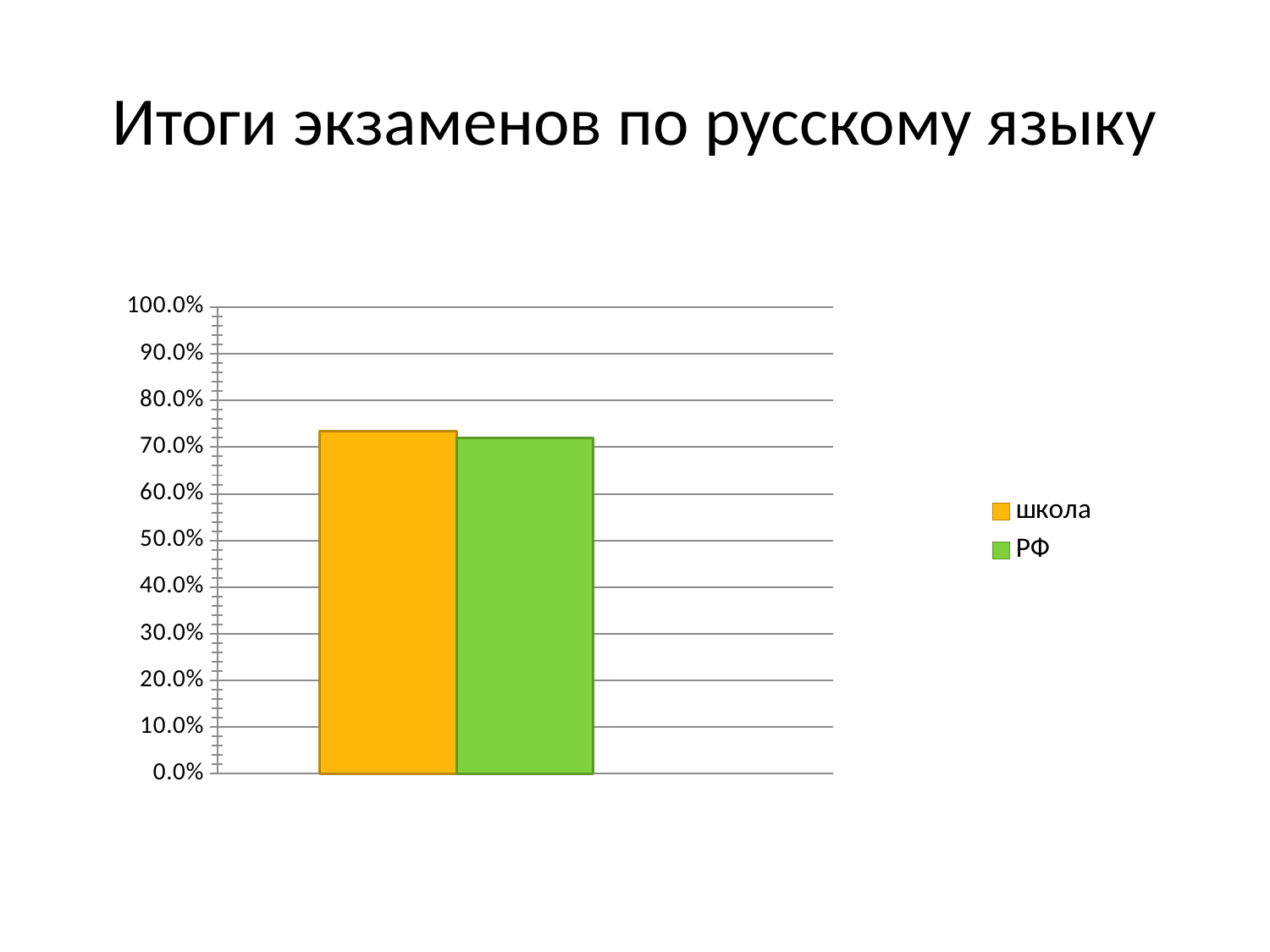
What is the title of the slide containing the chart? Итоги экзаменов по русскому языку How many series does the legend list? 2 How many bars are plotted on the chart? 2 Is the value for РФ greater or less than 90.0%? less Is the value for РФ greater or less than 80.0%? less Which series is shown in green in the legend? РФ Is the value for школа greater or less than 80.0%? less What kind of chart is shown on the slide? bar chart